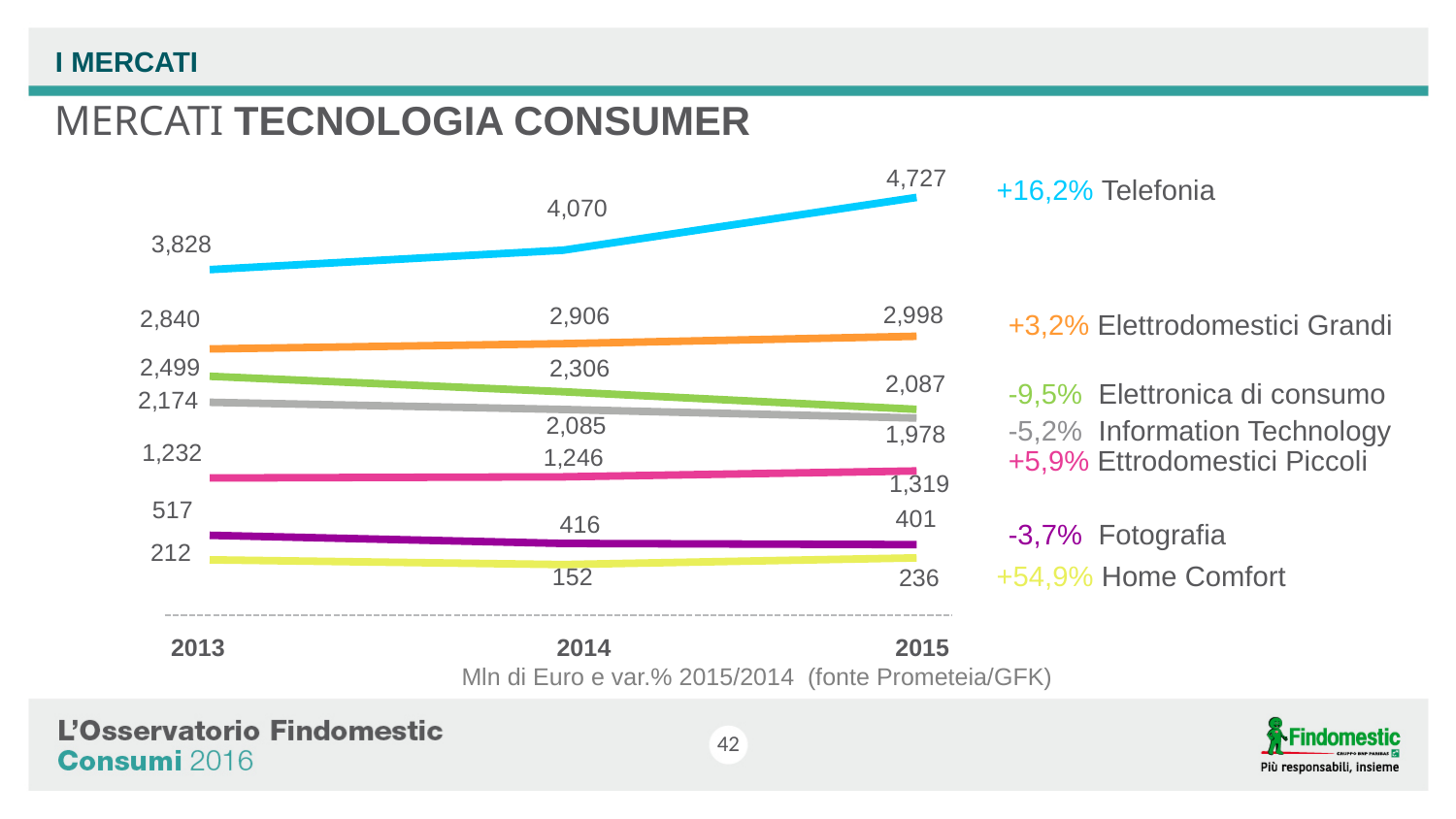
What is the value for Telefonia in 2015? 4,727 What type of chart is shown on the slide? Line chart Which series has the lowest value in 2013? Home Comfort How many series are listed in the legend on the right? 7 Does the Fotografia series rise or fall from 2013 to 2015? Fall How many years are shown on the x axis? 3 Which is larger in 2015: Elettronica di consumo or Information Technology? Elettronica di consumo What percentage change 2015/2014 is shown for Home Comfort? +54,9% Which series has the highest value in 2015? Telefonia What is the value for Elettrodomestici Grandi in 2013? 2,840 What is the value for Home Comfort in 2014? 152 What is the difference between the Telefonia values for 2015 and 2014? 657